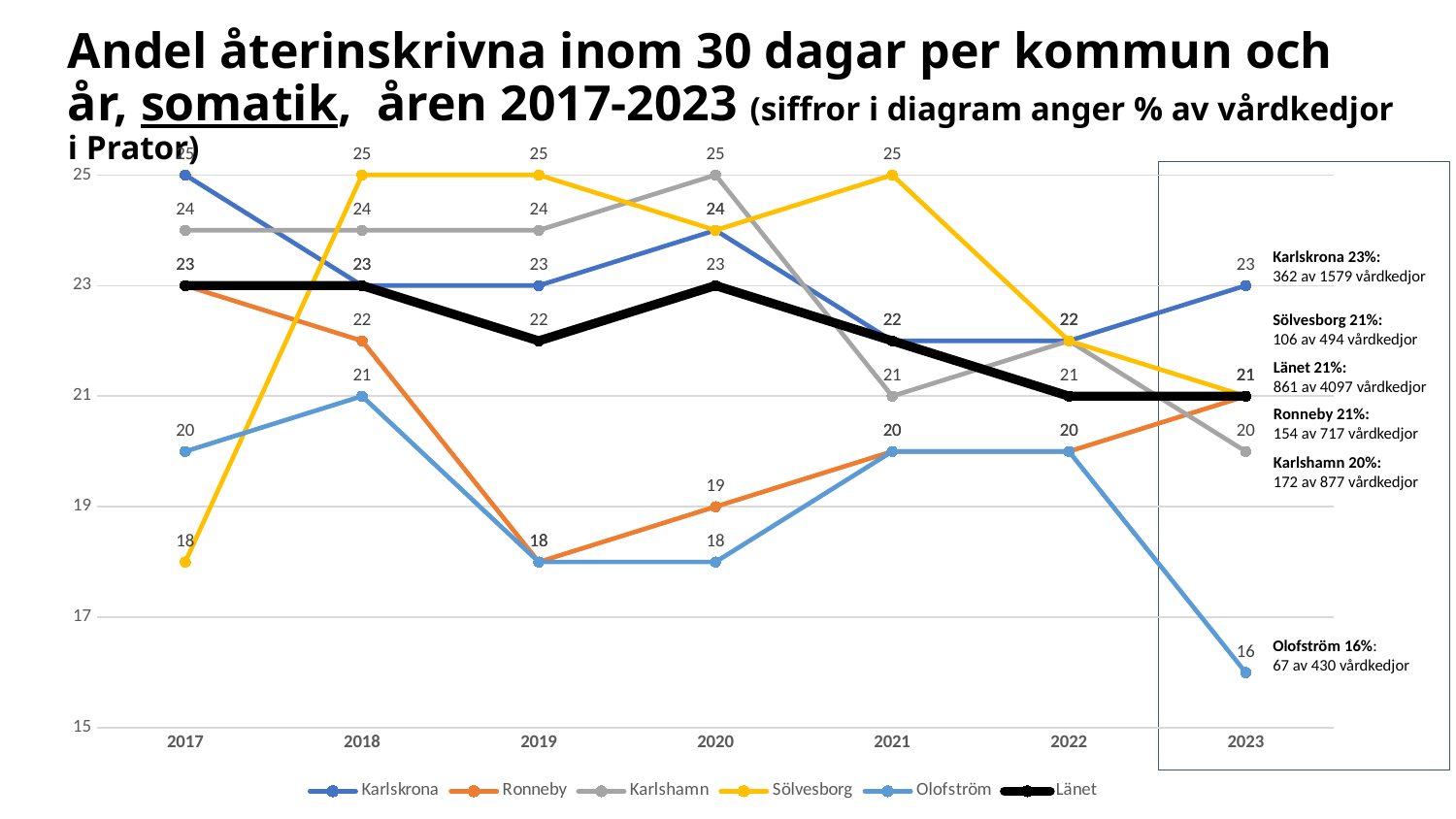
What is the value for Länet in 2019? 22 Which series has the lowest value in 2017? Sölvesborg What is the value for Olofström in 2023? 16 Does the Olofström line rise or fall from 2022 to 2023? fall Which is larger in 2017, Sölvesborg or Olofström? Olofström How many series does the legend list? 6 Which municipality has the lowest value in 2023? Olofström What is the difference between Karlskrona and Olofström in 2023? 7 What is the value for Karlskrona in 2017? 25 What kind of chart is shown on the slide? line chart How many years are shown on the x axis? 7 Which series has the highest value in 2023? Karlskrona